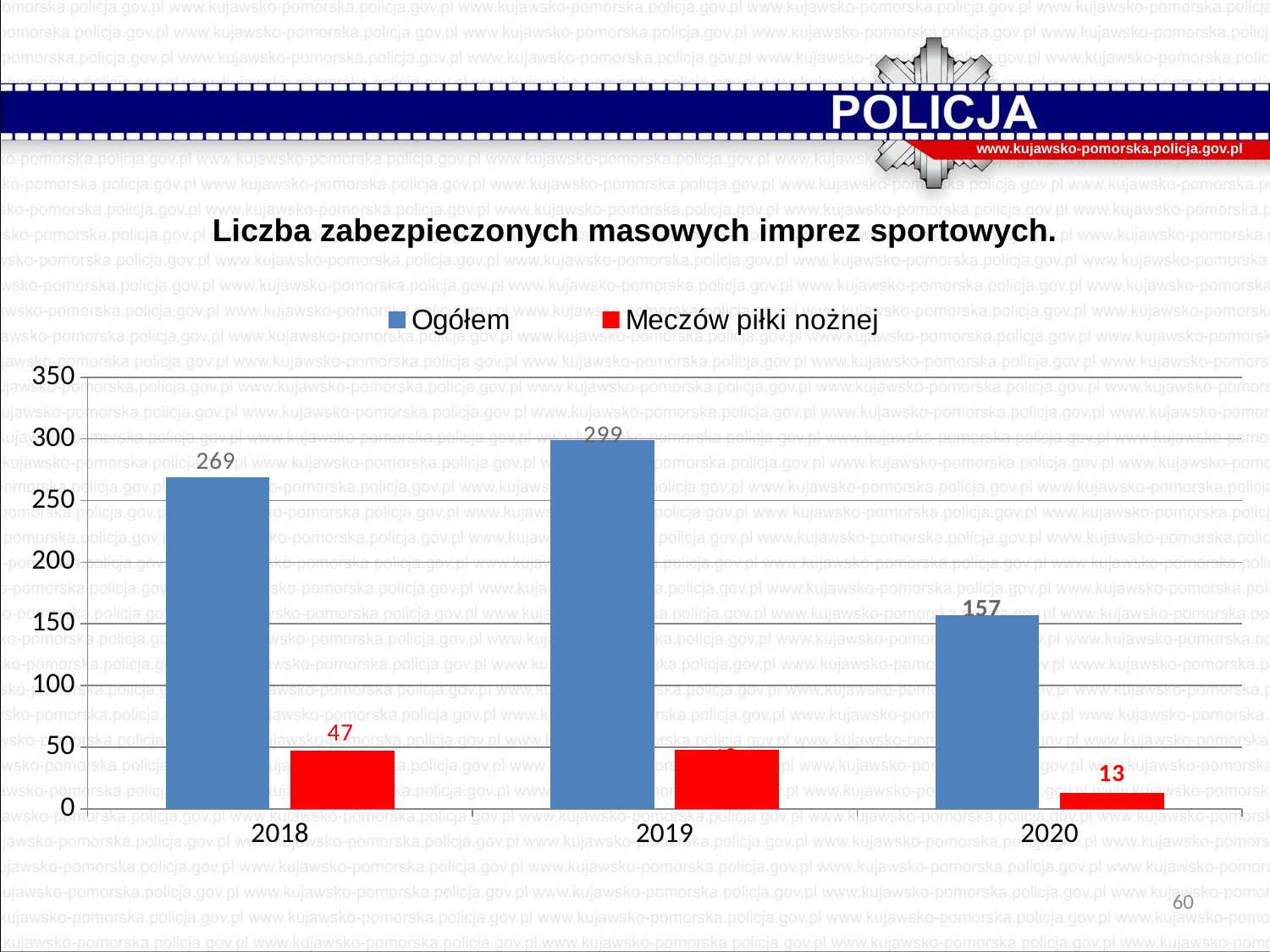
What is the value of Ogółem for 2020? 157 What is the value of Meczów piłki nożnej for 2020? 13 What is the value of Ogółem for 2018? 269 What is the difference between the Ogółem values for 2019 and 2018? 30 Is the Ogółem value for 2020 greater or less than 200? less In which year is the Ogółem value lowest? 2020 What is the title of the chart? Liczba zabezpieczonych masowych imprez sportowych. How many series does the legend list? 2 What is the value of Meczów piłki nożnej for 2018? 47 What is the value of Ogółem for 2019? 299 What is the difference between the Meczów piłki nożnej values for 2018 and 2020? 34 In which year is the Ogółem value highest? 2019